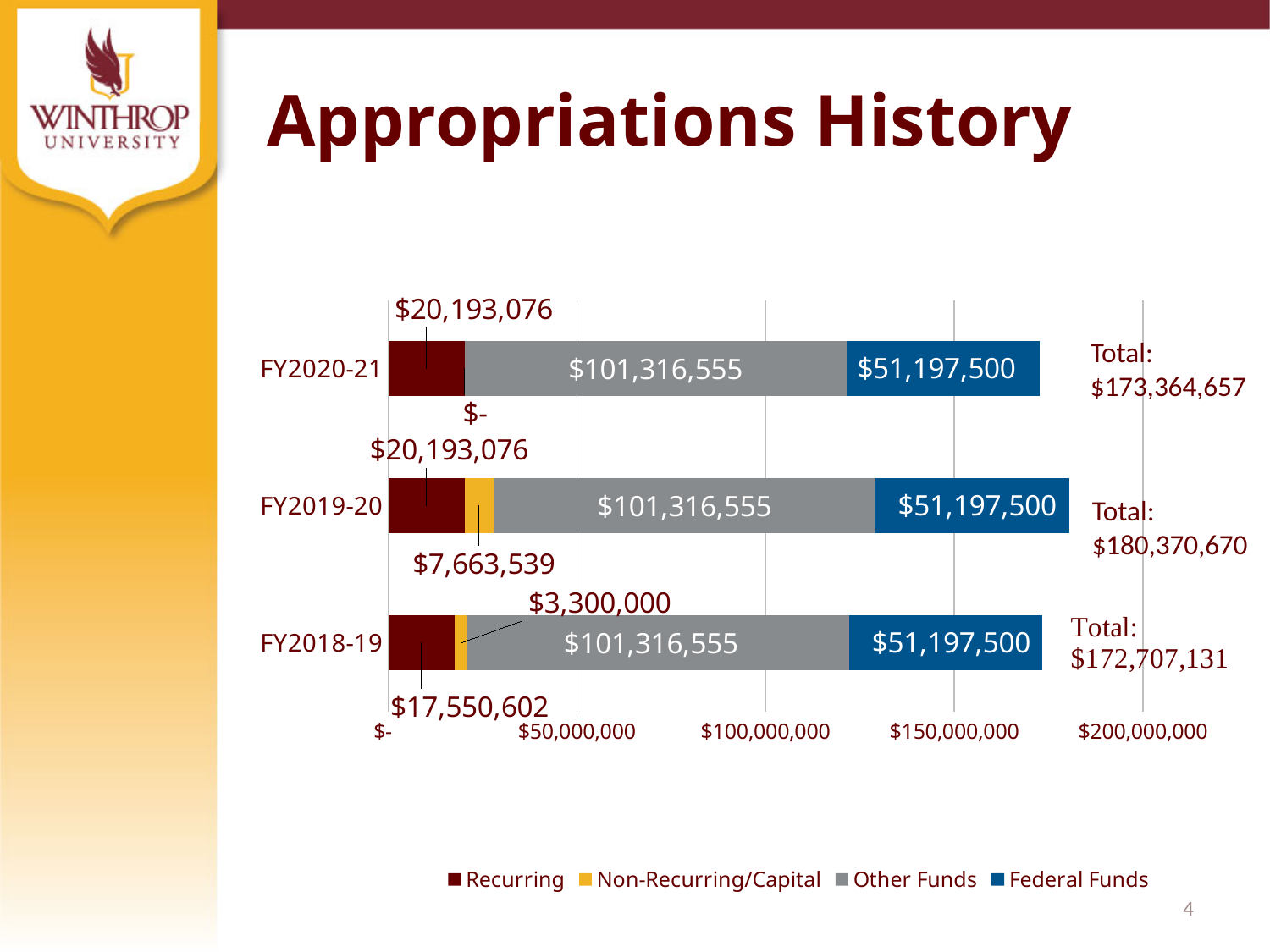
What is the Federal Funds value for FY2020-21? $51,197,500 What is the difference between the Non-Recurring/Capital values for FY2019-20 and FY2018-19? $4,363,539 How much larger is the Recurring value in FY2019-20 than in FY2018-19? $2,642,474 What is the Non-Recurring/Capital value shown for FY2020-21? $- How many series does the legend list? 4 What is the Recurring value for FY2018-19? $17,550,602 How many fiscal years are plotted in the chart? 3 Which fiscal year has the highest Non-Recurring/Capital value? FY2019-20 What total is shown for FY2019-20? $180,370,670 What is the Non-Recurring/Capital value for FY2019-20? $7,663,539 What type of chart is shown on the slide? Stacked bar chart In FY2019-20, which is larger: Other Funds or Federal Funds? Other Funds